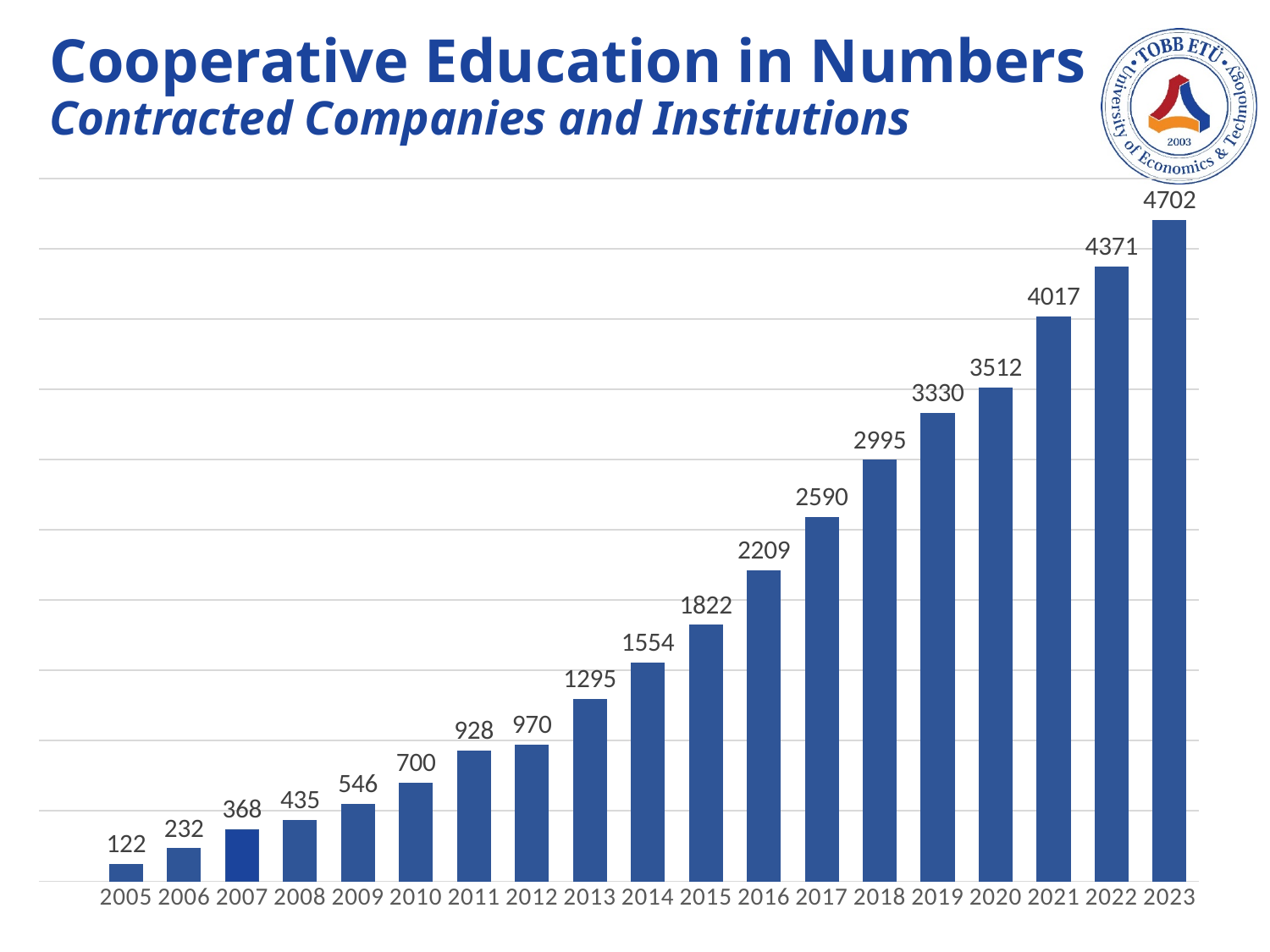
Which is larger, the value for 2010 or the value for 2011? 2011 What is the value for 2020? 3512 How many years are shown on the x axis? 19 What is the value for 2015? 1822 Which year has the highest value? 2023 What is the difference between the values for 2013 and 2012? 325 Which year has the lowest value? 2005 Do the values rise or fall from 2005 to 2023? rise What is the difference between the values for 2023 and 2022? 331 What is the value for 2005? 122 What is the subtitle of the slide above the chart? Contracted Companies and Institutions What kind of chart is this? bar chart